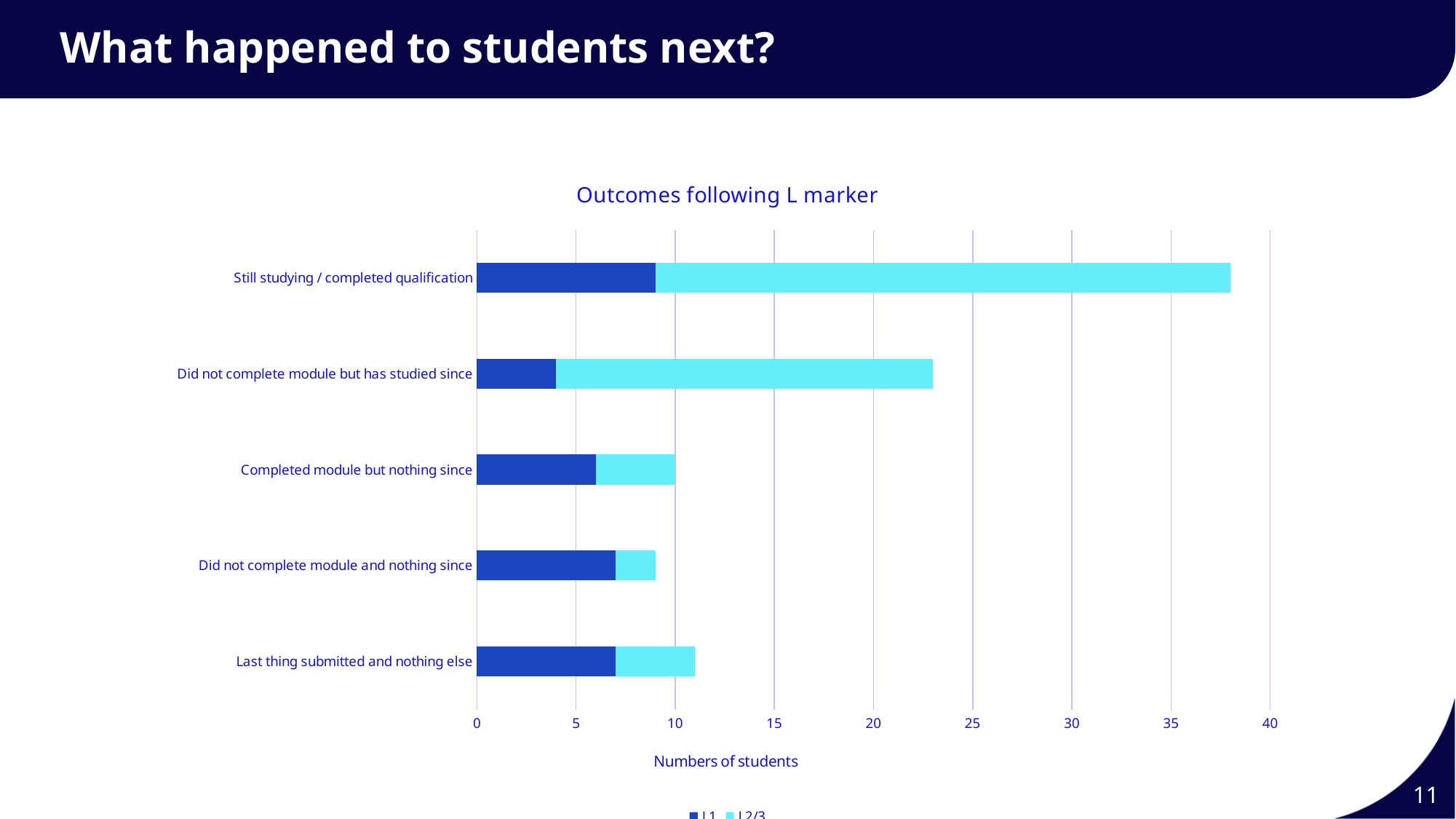
Is the L1 value for 'Did not complete module but has studied since' greater or less than 5? less Which category has the longest total bar? Still studying / completed qualification Is the total bar for 'Still studying / completed qualification' greater or less than 35? greater What is the title of the chart? Outcomes following L marker Which total bar is longer: 'Still studying / completed qualification' or 'Did not complete module but has studied since'? Still studying / completed qualification Is the total bar for 'Did not complete module but has studied since' greater or less than 20? greater How many categories are plotted on the chart? 5 What is the label on the horizontal axis? Numbers of students How many series does the legend list? 2 What kind of chart is shown on the slide? Bar chart For 'Still studying / completed qualification', which series has the larger segment, L1 or L2/3? L2/3